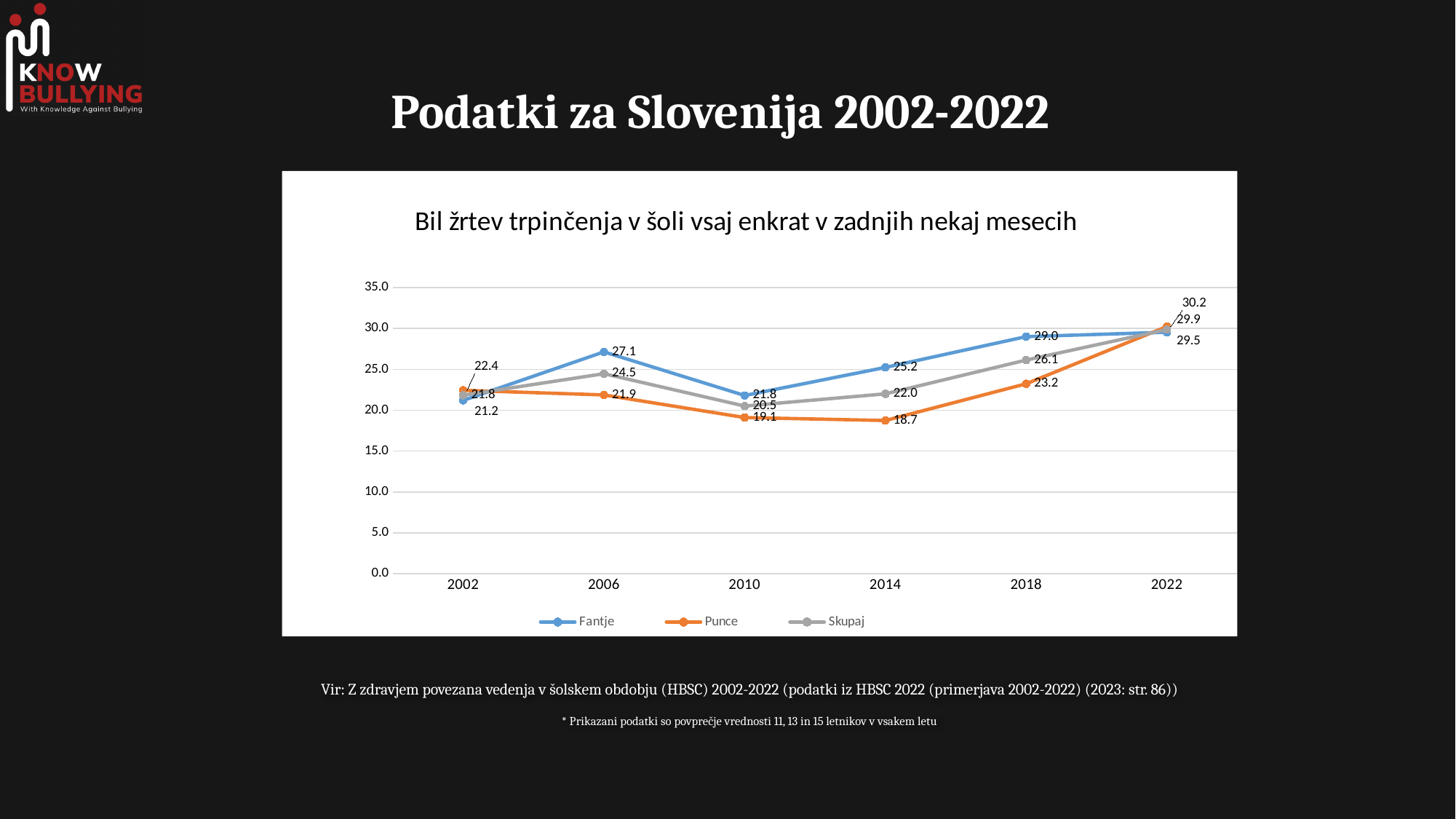
Which series has the larger value in 2010, Fantje or Punce? Fantje How many series does the chart legend list? 3 Does the Punce series rise or fall from 2014 to 2022? rise In which year is the Fantje series at its highest? 2022 In which year is the Punce series at its lowest? 2014 How many years are plotted along the x axis of the chart? 6 What is the value for Punce in 2014? 18.7 What is the difference between the Fantje and Punce values in 2018? 5.8 What is the value for Punce in 2022? 30.2 What is the value for Fantje in 2006? 27.1 What is the value for Skupaj in 2018? 26.1 What kind of chart is shown on the slide? line chart